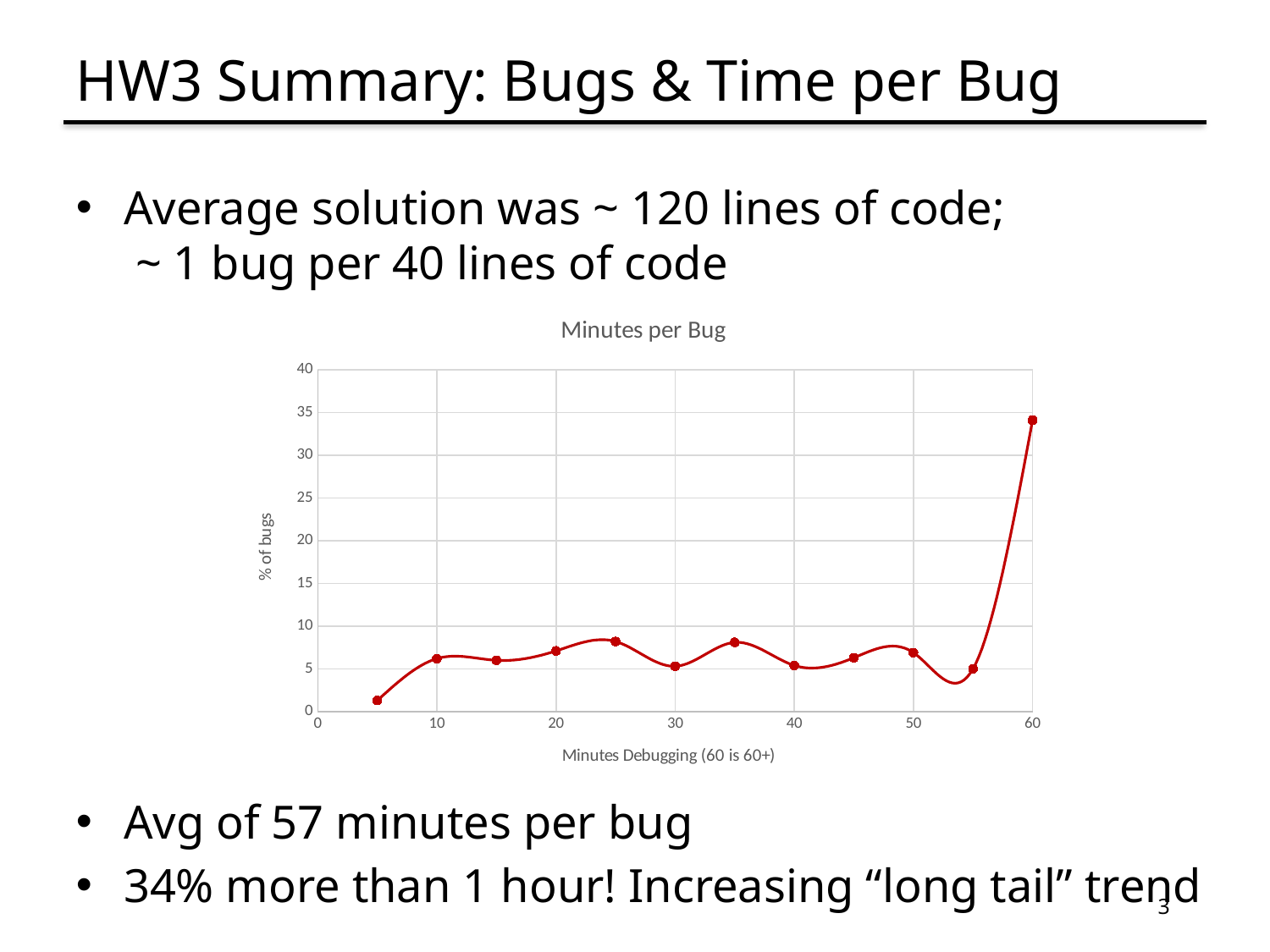
What is the title of the chart? Minutes per Bug Does the % of bugs rise or fall between 55 and 60 minutes? rise Is the % of bugs at 60 minutes greater or less than 30? greater Is the % of bugs at 5 minutes greater or less than 5? less What is the label of the x axis? Minutes Debugging (60 is 60+) Which has a higher % of bugs: 60 minutes or 55 minutes? 60 minutes What kind of chart is shown on the slide? line chart Which has a higher % of bugs: 10 minutes or 5 minutes? 10 minutes Is the % of bugs at 25 minutes greater or less than 10? less At which value of Minutes Debugging is the % of bugs lowest? 5 At which value of Minutes Debugging is the % of bugs highest? 60 How many data points are plotted on the chart? 12